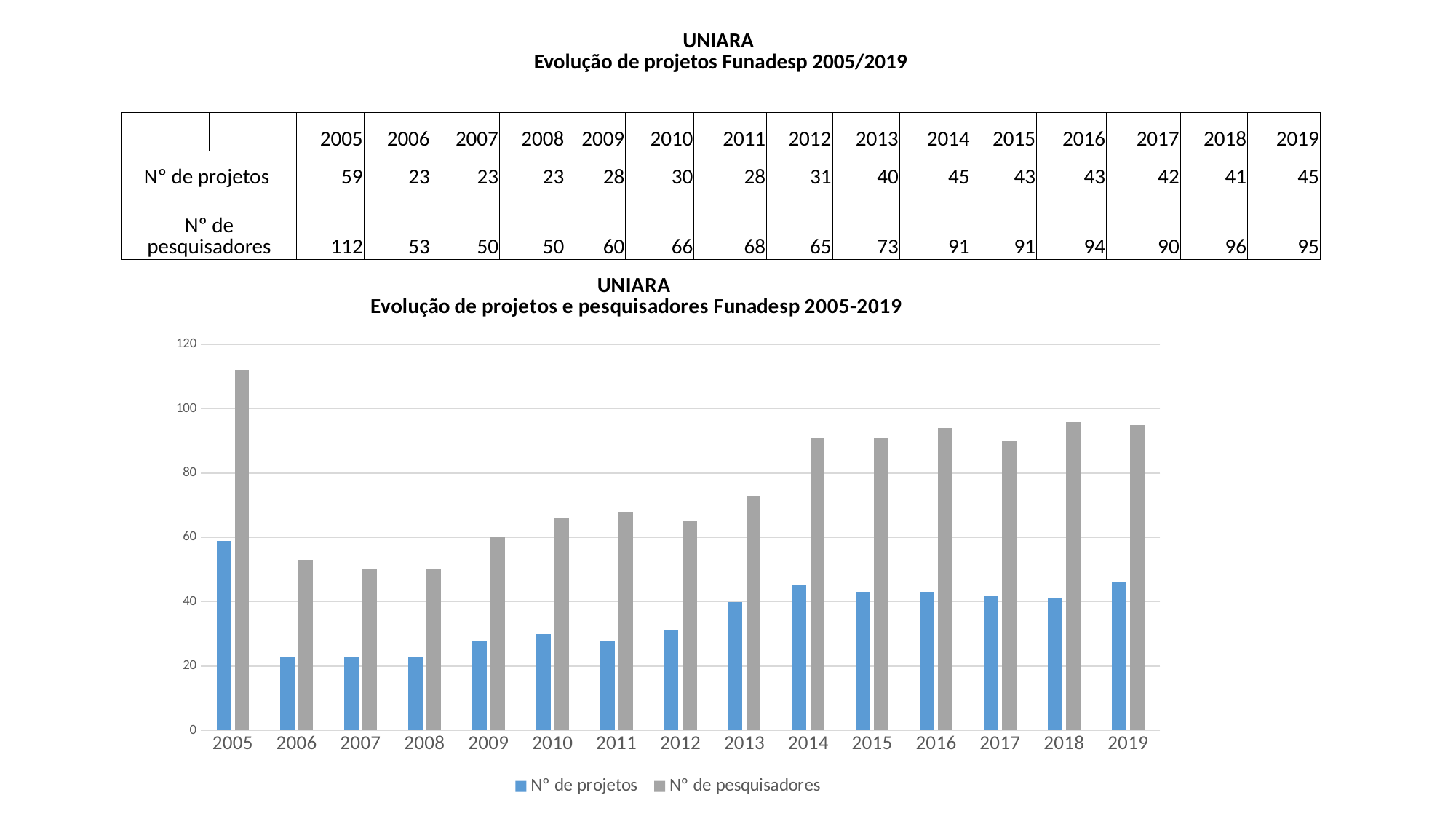
How many series does the chart legend list? 2 What is the value of N° de pesquisadores for 2005? 112 Which year has the highest value for N° de pesquisadores? 2005 How many years are shown on the x axis of the chart? 15 Does N° de pesquisadores rise or fall from 2008 to 2014? rise What is the difference between N° de pesquisadores and N° de projetos in 2018? 55 Is the value of N° de pesquisadores for 2005 greater or less than 100? greater What type of chart is shown on the slide? bar chart What is the value of N° de projetos for 2019? 45 Which is larger in 2014, N° de projetos or N° de pesquisadores? N° de pesquisadores Is the value of N° de projetos for 2006 greater or less than 40? less